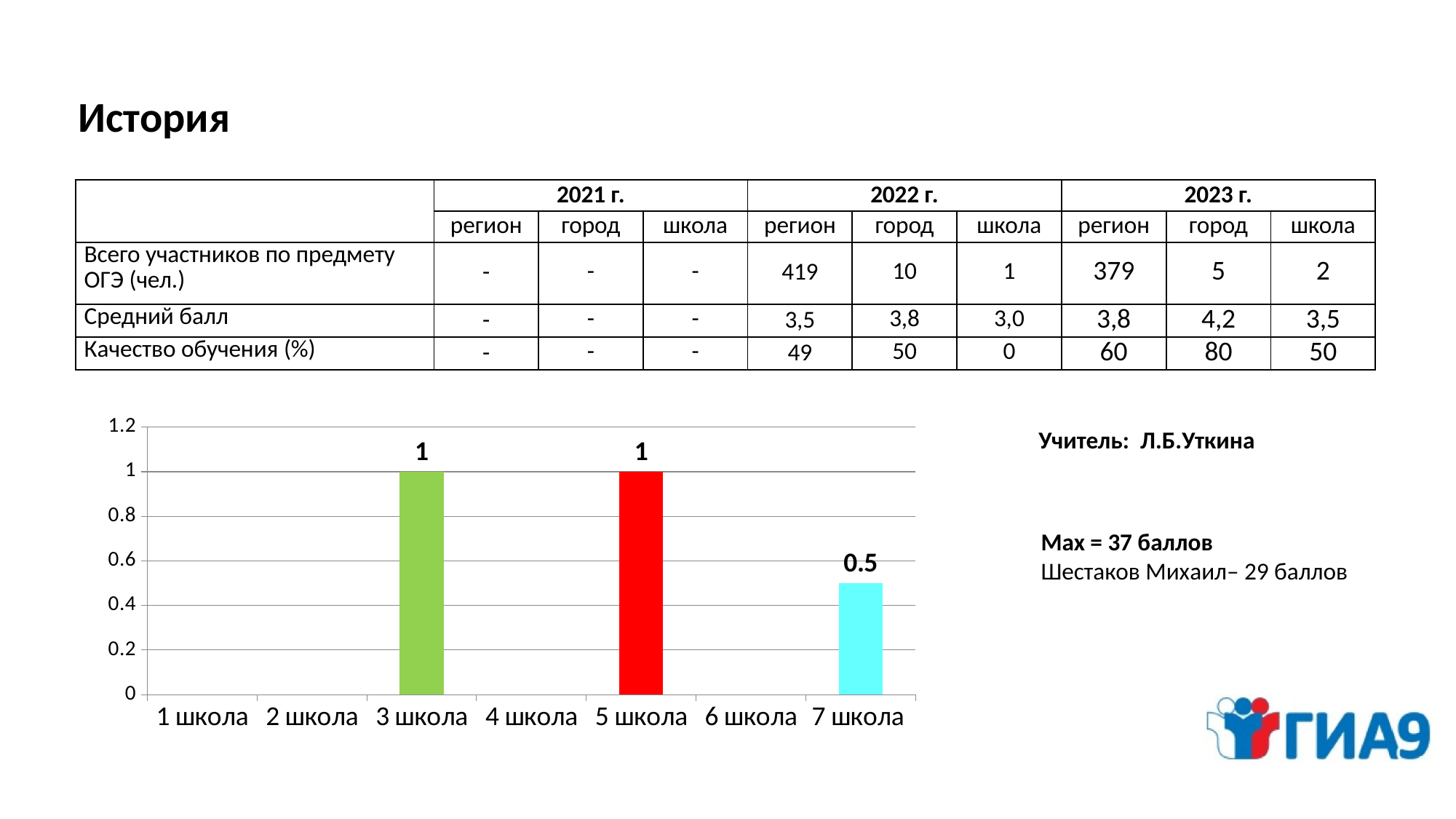
Which is larger, the value for 5 школа or the value for 7 школа? 5 школа What is the difference between the values for 3 школа and 7 школа? 0.5 What is the value for 7 школа in the chart? 0.5 Which category has the lowest non-zero bar in the chart? 7 школа What kind of chart is shown on the slide? bar chart Is the value for 7 школа greater or less than 0.6? less What is the value for 3 школа in the chart? 1 How many bars in the chart have a visible non-zero value? 3 What colour is the bar for 5 школа? red What is the highest value shown on the y axis of the chart? 1.2 How many categories are shown on the x axis of the chart? 7 What is the value for 5 школа in the chart? 1